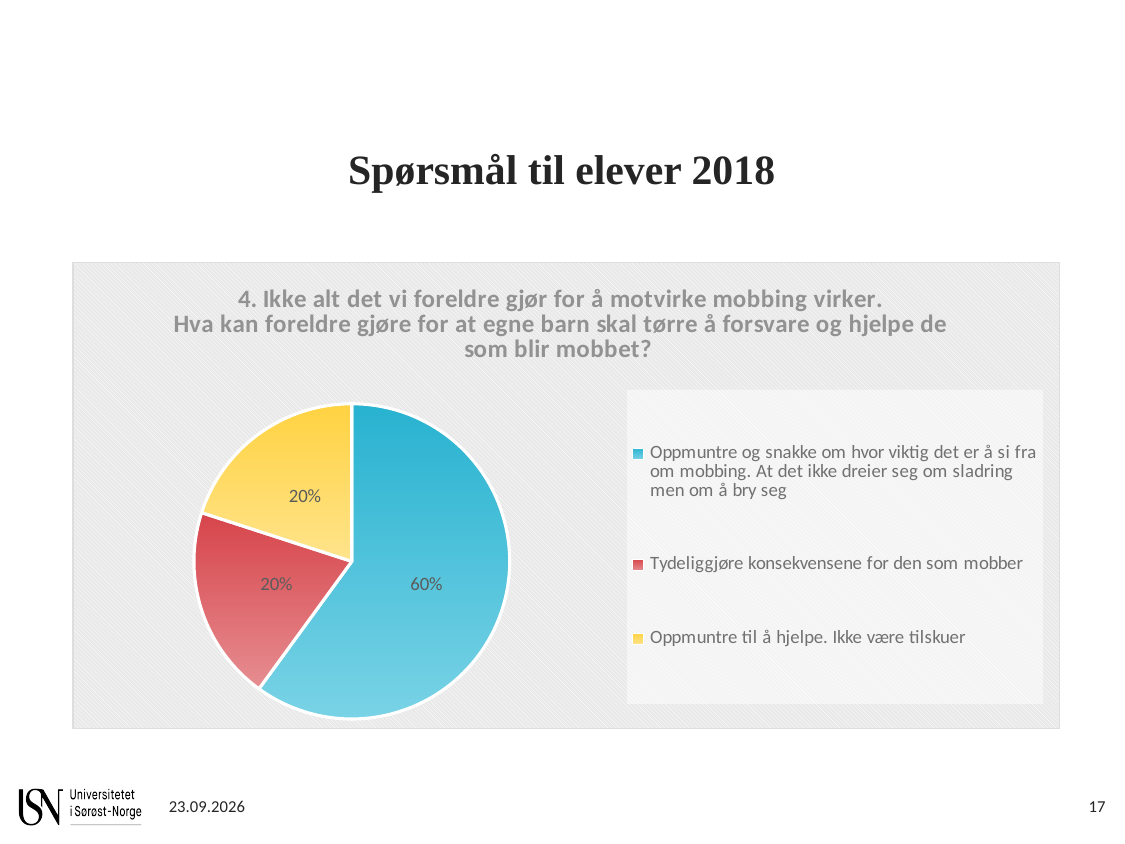
How many entries does the legend list? 3 How many slices does the pie chart have? 3 What share of the pie does "Tydeliggjøre konsekvensene for den som mobber" represent? 20% Which category has the largest slice of the pie? Oppmuntre og snakke om hvor viktig det er å si fra om mobbing. At det ikke dreier seg om sladring men om å bry seg Which is larger: the slice for "Oppmuntre til å hjelpe. Ikke være tilskuer" or the slice for "Oppmuntre og snakke om hvor viktig det er å si fra om mobbing. At det ikke dreier seg om sladring men om å bry seg"? Oppmuntre og snakke om hvor viktig det er å si fra om mobbing. At det ikke dreier seg om sladring men om å bry seg What is the value for the slice "Oppmuntre og snakke om hvor viktig det er å si fra om mobbing. At det ikke dreier seg om sladring men om å bry seg"? 60% Is the value for "Tydeliggjøre konsekvensene for den som mobber" greater or less than 50%? less What share of the pie does "Oppmuntre til å hjelpe. Ikke være tilskuer" represent? 20% What type of chart is shown on the slide? pie chart What is the difference between the largest slice and the slice for "Tydeliggjøre konsekvensene for den som mobber"? 40% What colour is the slice for "Oppmuntre til å hjelpe. Ikke være tilskuer"? yellow What is the title of the slide? Spørsmål til elever 2018